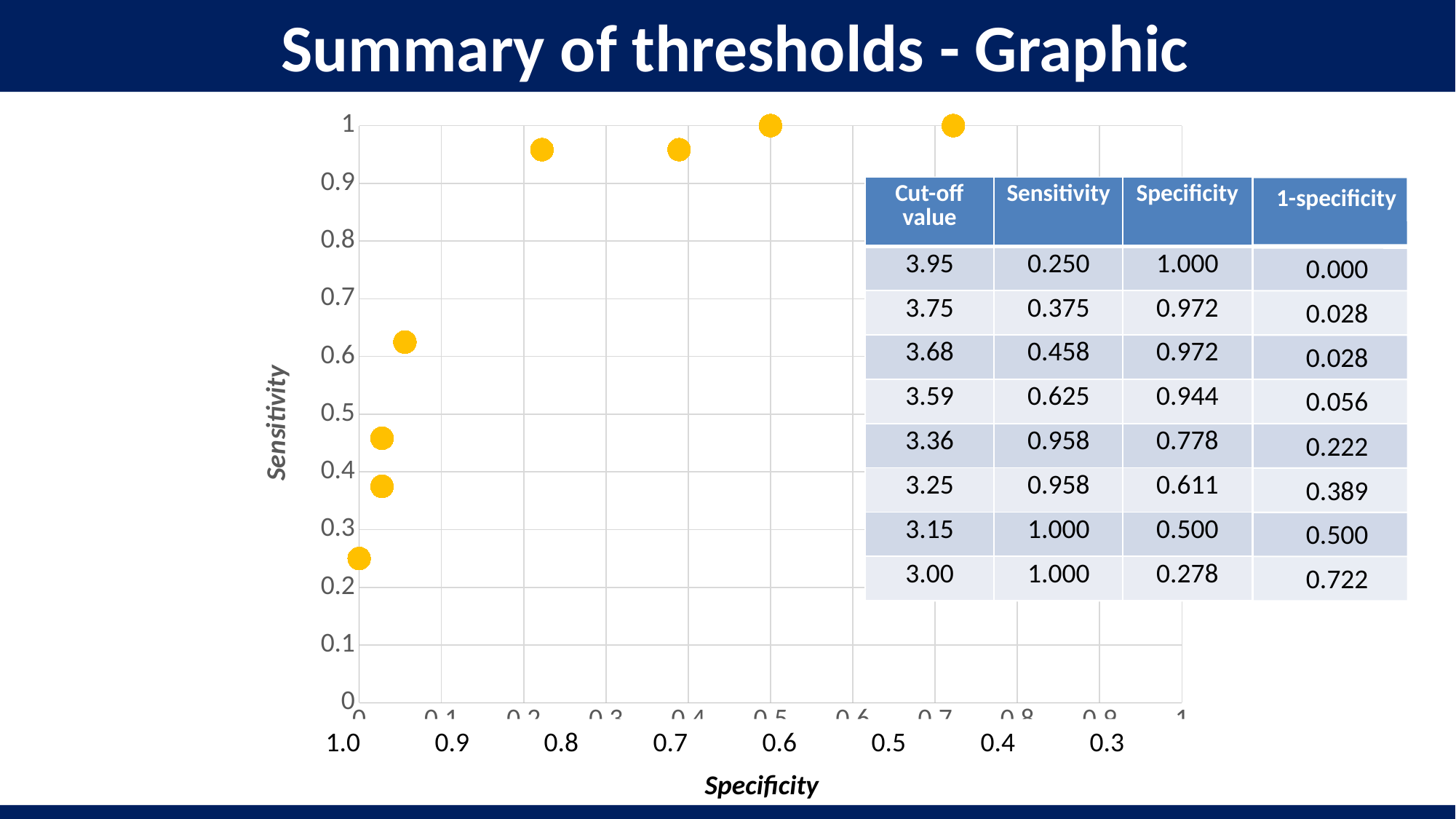
Do the plotted sensitivity values rise or fall as you move from left to right along the x axis? Rise What kind of chart is shown on the slide? Scatter chart Is the sensitivity of the lowest plotted point greater or less than 0.3? less What is the label of the vertical axis of the chart? Sensitivity What is the sensitivity of the point plotted directly above the 0.5 tick on the grey x axis? 1 How many plotted points have a sensitivity of 1? 2 What is the label printed below the horizontal axis of the chart? Specificity Is the sensitivity of the point plotted just above the 0.2 tick on the grey x axis greater or less than 0.9? greater What is the highest sensitivity value reached by any plotted point? 1 At which grey x-axis tick does the point with the lowest sensitivity sit? 0 How many data points are plotted on the chart? 8